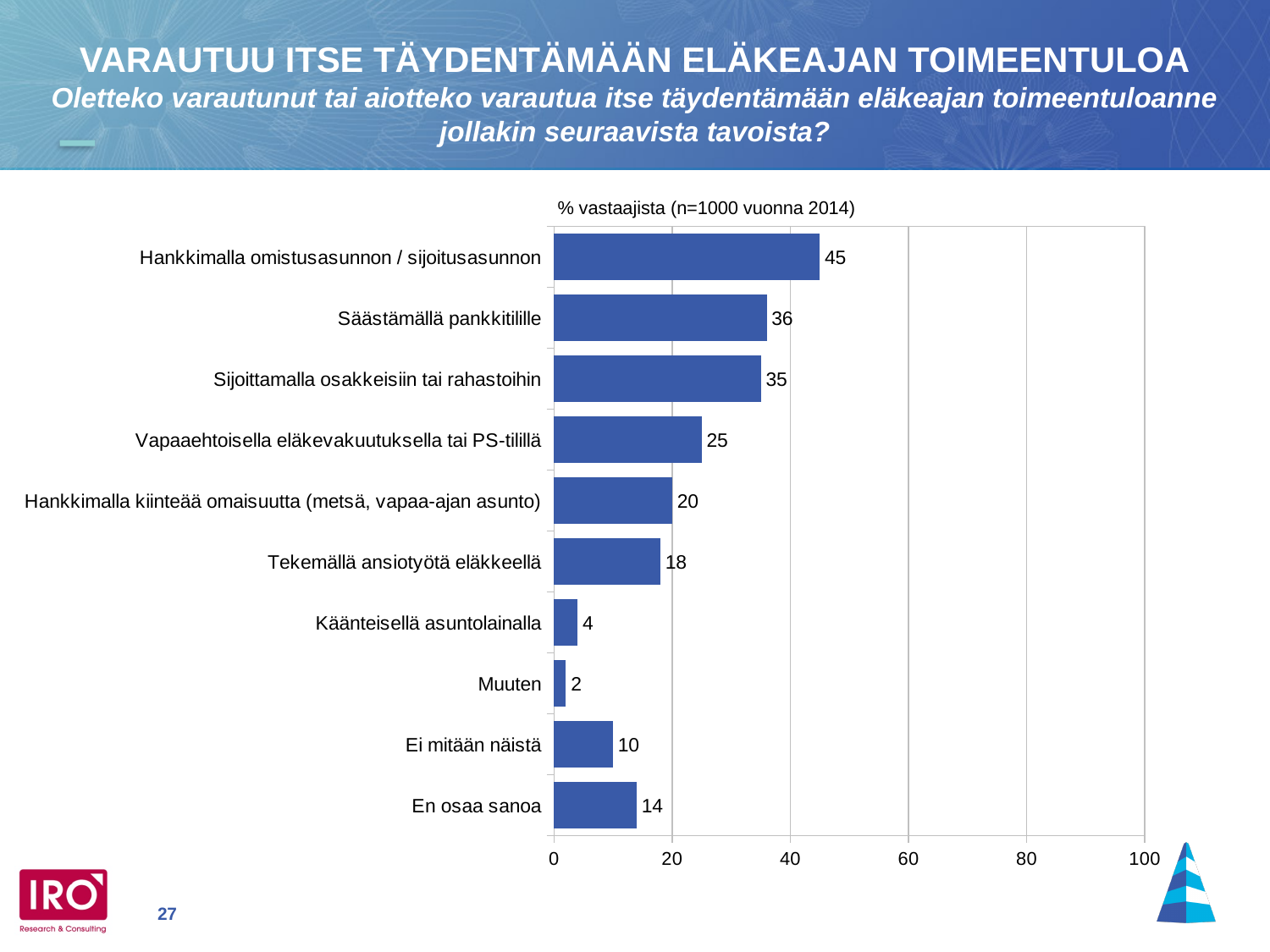
What is the difference between the values for "Säästämällä pankkitilille" and "Tekemällä ansiotyötä eläkkeellä"? 18 What is the value for "Käänteisellä asuntolainalla"? 4 How many categories are shown in the chart? 10 Which category has the highest value? Hankkimalla omistusasunnon / sijoitusasunnon What kind of chart is shown on the slide? bar chart Which is larger, the value for "En osaa sanoa" or the value for "Ei mitään näistä"? En osaa sanoa What is the value for "Vapaaehtoisella eläkevakuutuksella tai PS-tilillä"? 25 Which category has the lowest value? Muuten What is the title shown above the chart? % vastaajista (n=1000 vuonna 2014) Is the value for "Sijoittamalla osakkeisiin tai rahastoihin" greater or less than 40? less What is the value for "Hankkimalla omistusasunnon / sijoitusasunnon"? 45 What is the value for "Ei mitään näistä"? 10